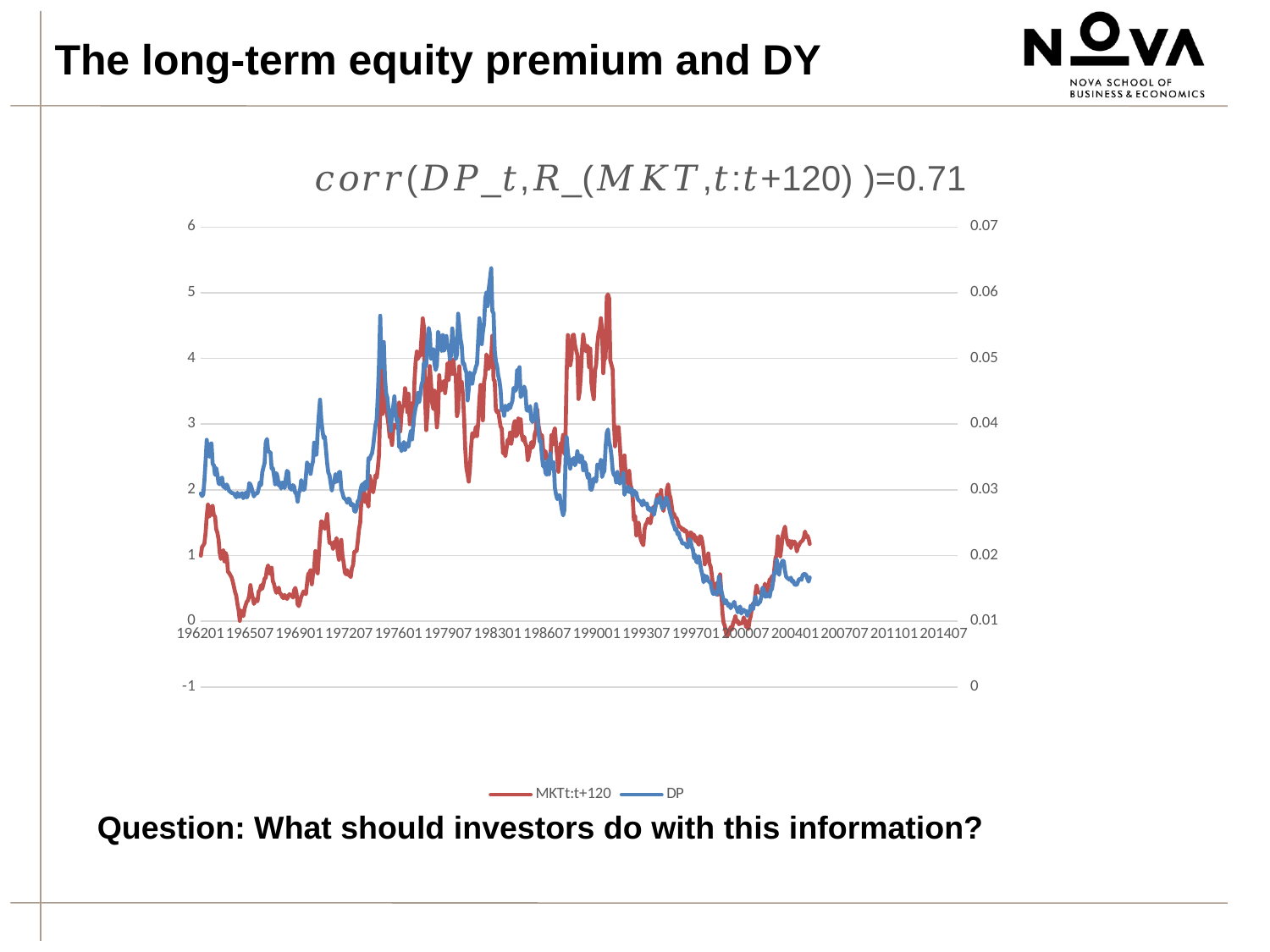
Does the MKTt:t+120 series rise or fall between 196901 and 197601? rise Does the MKTt:t+120 series rise or fall between 199001 and 200007? fall Is the value of the MKTt:t+120 series around 200007 greater or less than 1 on the left axis? less Is the peak value of the MKTt:t+120 series near 199001 greater or less than 4 on the left axis? greater Which colour is used for the DP series in the legend? blue What kind of chart is shown on the slide? line chart Does the DP series rise or fall between 199001 and 200007? fall What correlation value is stated in the chart title? 0.71 How many series does the legend list? 2 How many date labels are shown on the x axis? 16